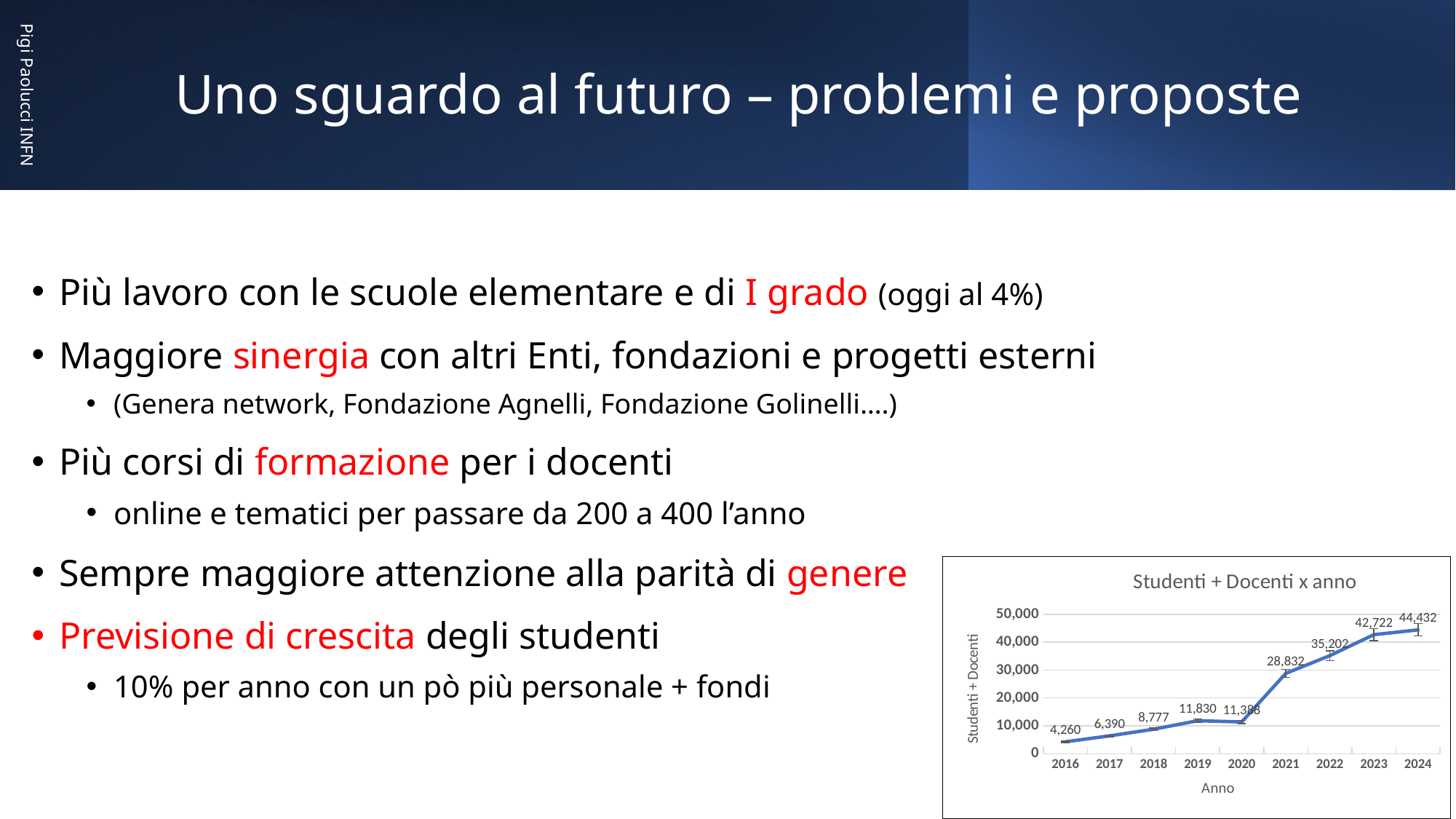
Is the value for 2022 greater or less than 30,000? greater What is the title of the chart? Studenti + Docenti x anno What is the value for 2021 in the chart? 28,832 What is the value for 2019 in the chart? 11,830 Which year has the highest value in the chart? 2024 How many years are plotted on the x axis of the chart? 9 What is the difference between the values for 2024 and 2023? 1,710 What is the value for 2016 in the chart? 4,260 Which year has the lowest value in the chart? 2016 What is the value for 2024 in the chart? 44,432 What type of chart is shown on the slide? line chart Which is larger, the value for 2022 or the value for 2021? 2022